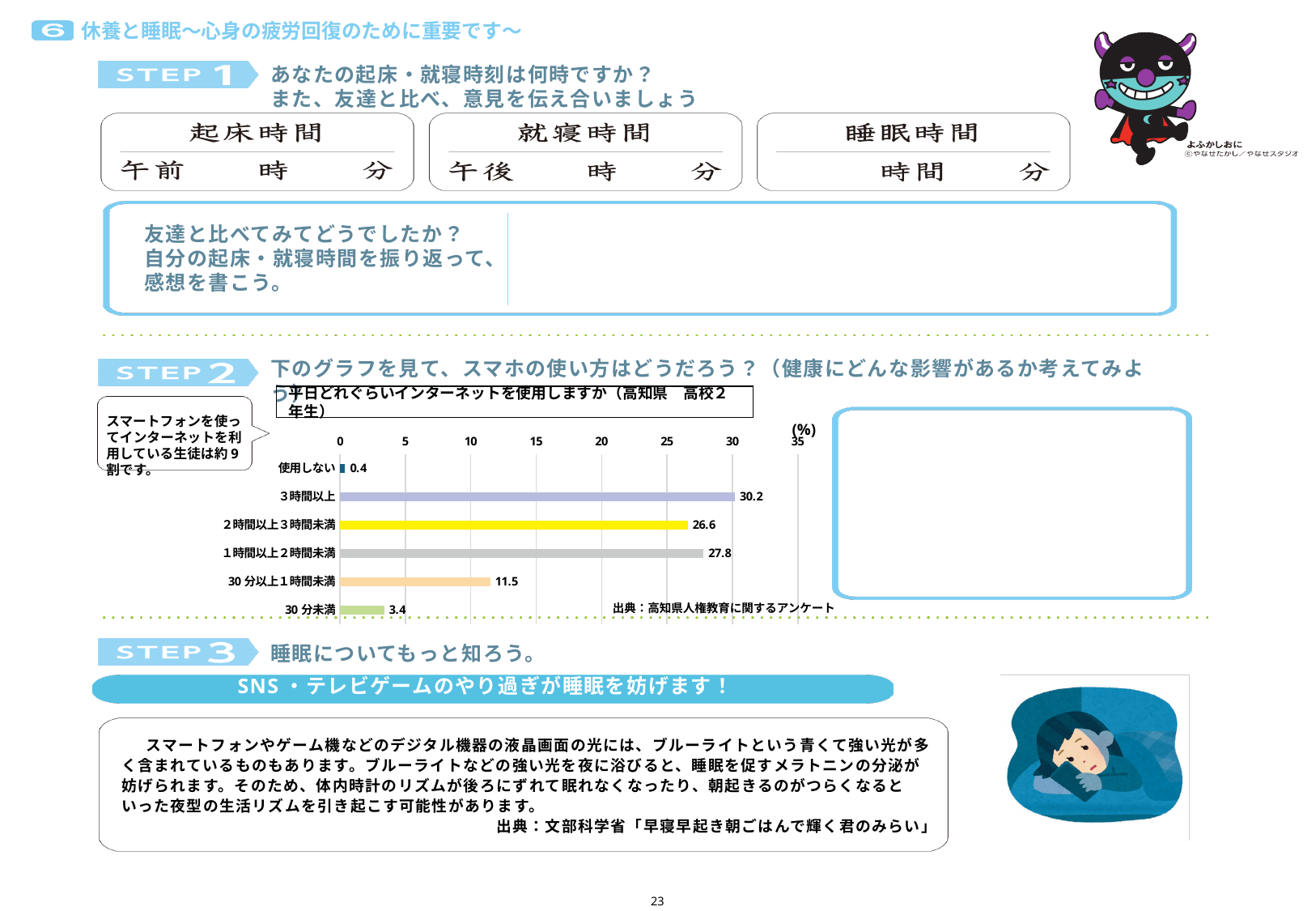
Is the value for 1時間以上2時間未満 greater or less than 25? greater Which is larger, the value for 30分未満 or the value for 30分以上1時間未満? 30分以上1時間未満 What is the value for 2時間以上3時間未満? 26.6 How many categories are shown in the chart? 6 Which category has the highest value? 3時間以上 What is the value for 3時間以上? 30.2 What is the value for 30分以上1時間未満? 11.5 What type of chart is shown on the slide? bar chart What is the value for 使用しない? 0.4 Which category has the lowest value? 使用しない What is the unit shown at the end of the horizontal axis? (%) What is the difference between the values for 1時間以上2時間未満 and 2時間以上3時間未満? 1.2